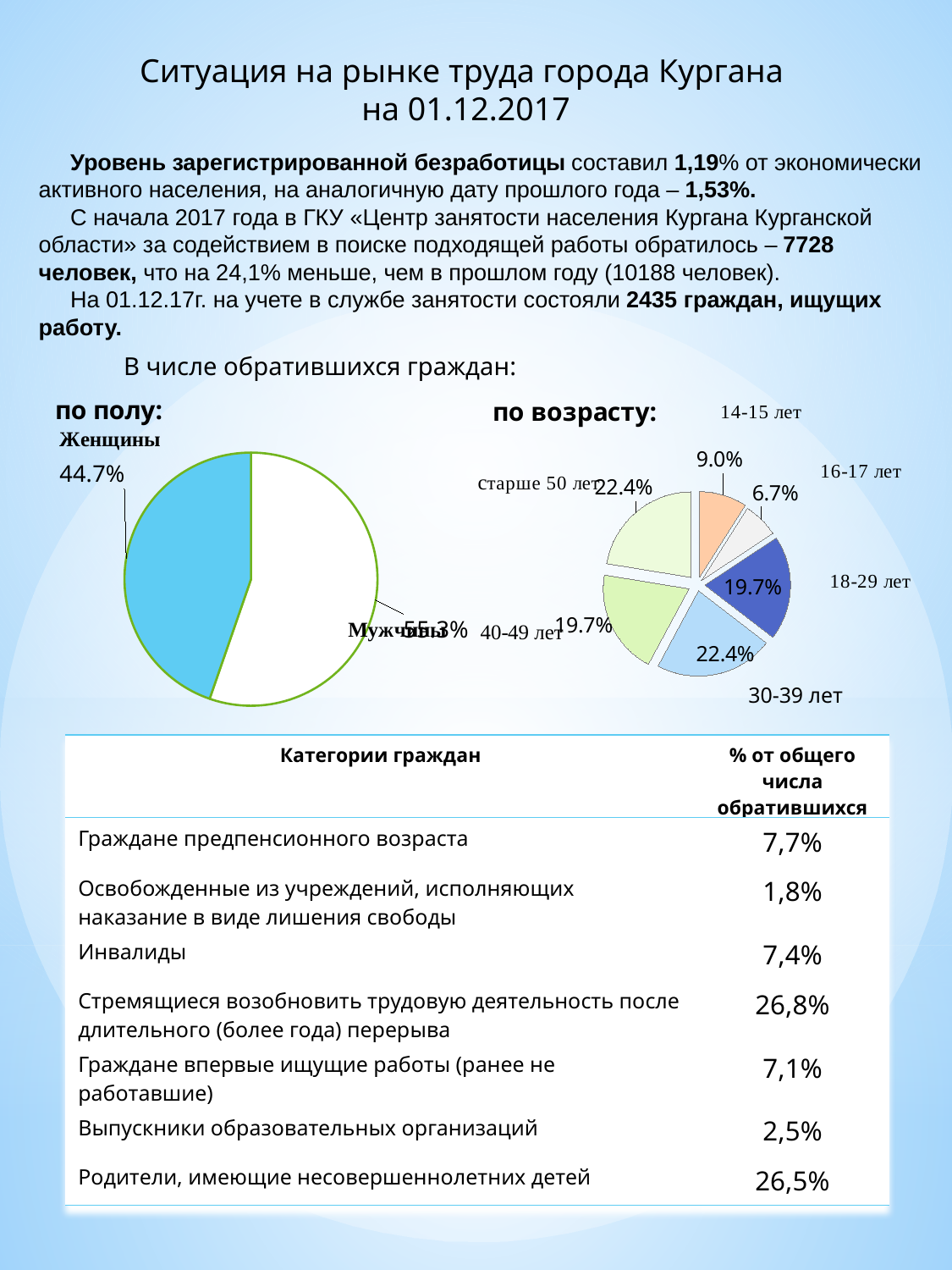
In the 'по полу' chart, what is the difference between the Мужчины and Женщины shares? 10.6% In the 'по возрасту' chart, what share is shown for 18-29 лет? 19.7% In the 'по возрасту' chart, which age group has the smallest share? 16-17 лет In the 'по полу' chart, what share is shown for Женщины? 44.7% In the 'по полу' chart, what share is shown for Мужчины? 55.3% In the 'по возрасту' chart, what share is shown for 14-15 лет? 9.0% In the 'по возрасту' chart, what is the difference between the shares for 14-15 лет and 16-17 лет? 2.3% How many slices does the 'по возрасту' chart have? 6 In the 'по полу' chart, which slice is larger, Женщины or Мужчины? Мужчины What kind of chart is the 'по полу' chart? pie chart In the 'по возрасту' chart, what share is shown for 30-39 лет? 22.4% In the 'по возрасту' chart, which is larger, the share for 14-15 лет or for 16-17 лет? 14-15 лет